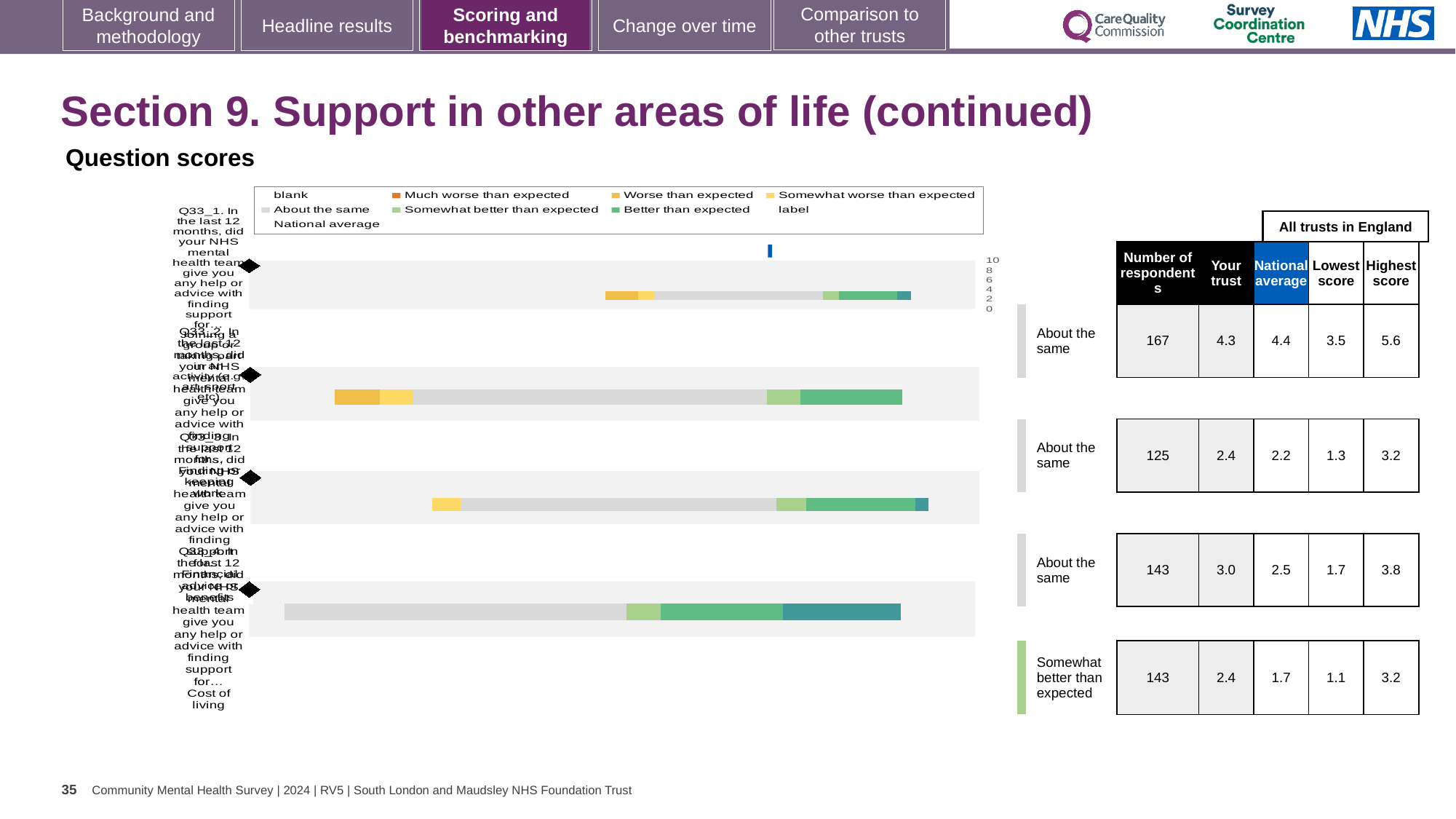
In the table beside the chart, is the 'Your trust' score for the third question (Q33_3) higher or lower than its national average? higher How many entries does the chart legend list? 9 What kind of chart is shown under 'Question scores'? bar chart In the table beside the chart, what is the difference between the 'Your trust' score and the national average for the last question (Q33_4, Cost of living)? 0.7 In the table beside the chart, which question has the highest 'Your trust' score? Q33_1 In the table beside the chart, what is the highest score for the last question (Q33_4, Cost of living)? 3.2 What benchmark category is shown for the last question (Q33_4, Cost of living)? Somewhat better than expected In the table beside the chart, what is the lowest score for the second question (Q33_2)? 1.3 In the table beside the chart, how many respondents are listed for the first question (Q33_1)? 167 In the table beside the chart, what is the 'Your trust' score for the first question (Q33_1)? 4.3 In the table beside the chart, what is the national average for the first question (Q33_1)? 4.4 How many question bars are plotted in the chart? 4